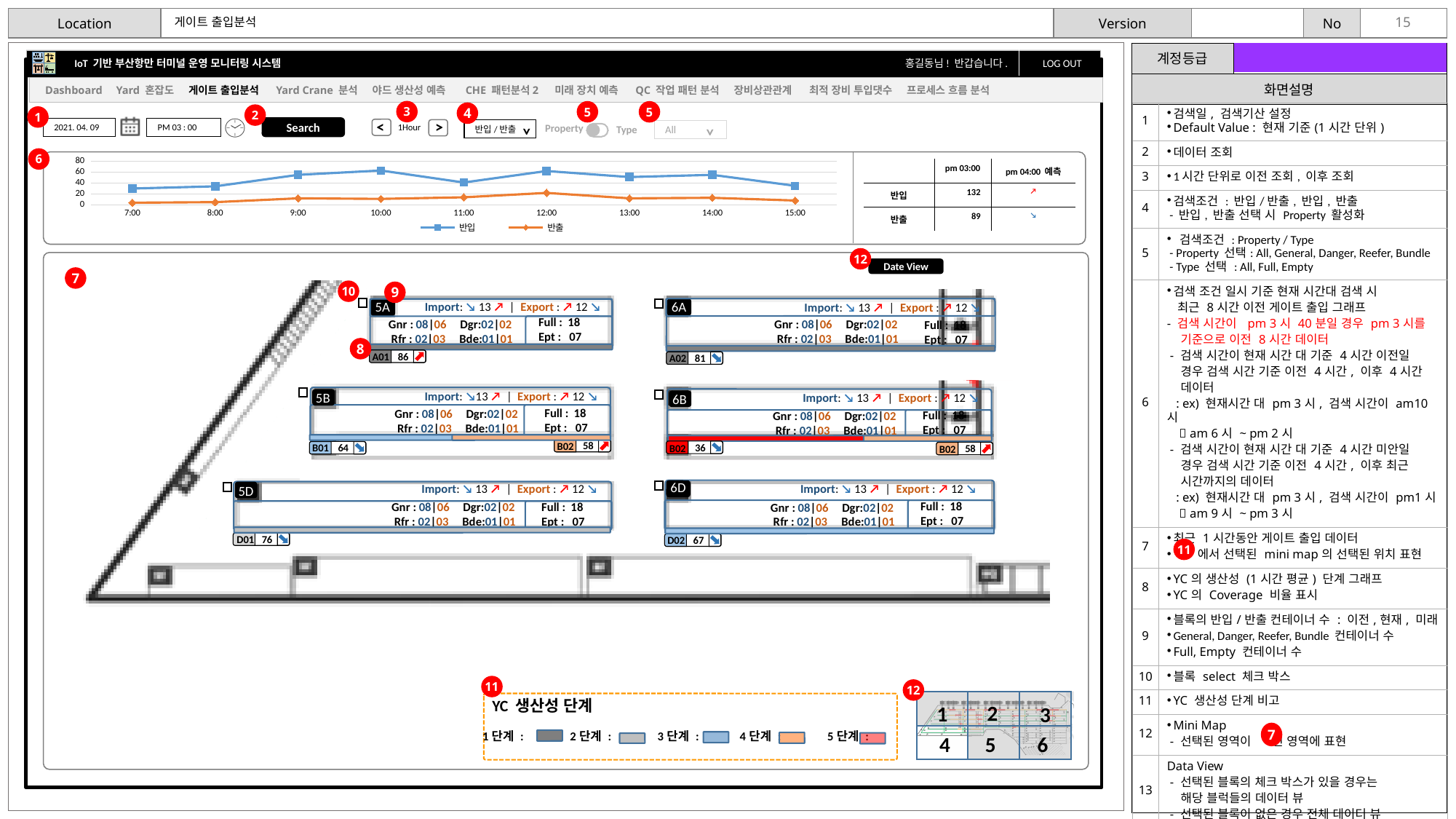
What kind of chart is shown at the top of the slide (item 6)? line chart What is the highest value shown on the y axis of the line chart? 80 Is the value for 반입 at 10:00 greater or less than 40? greater Is the value for 반출 at 12:00 greater or less than 40? less How many time points are plotted along the x axis of the line chart? 9 Is the value for 반출 at 7:00 greater or less than 20? less At 12:00, which series has the larger value, 반입 or 반출? 반입 How many series does the legend of the line chart list? 2 For the 반입 series, which is larger: the value at 11:00 or the value at 12:00? 12:00 At which time does the 반출 series reach its highest value? 12:00 What are the two series named in the legend of the line chart? 반입 and 반출